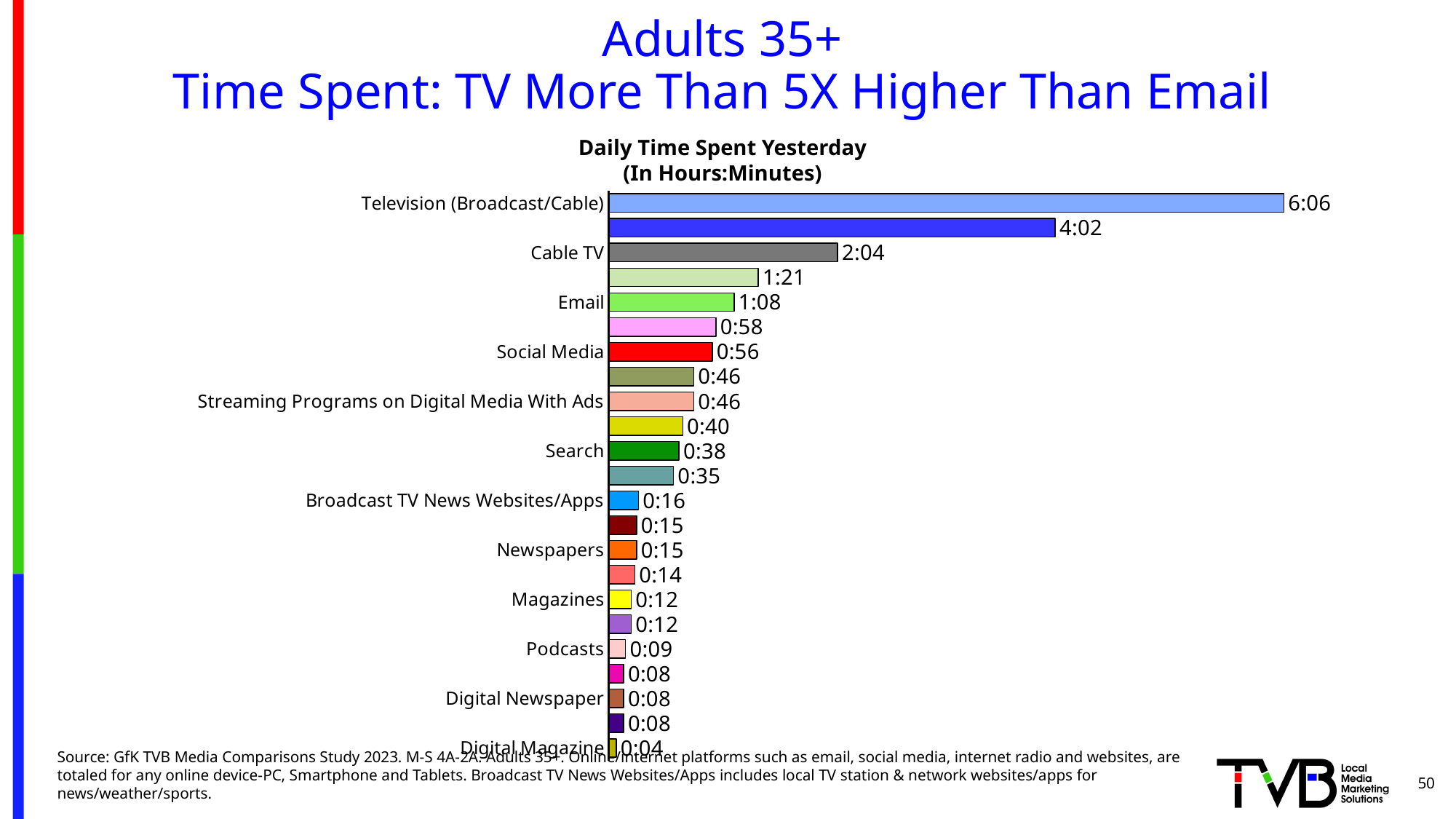
What is the difference in daily time spent between Cable TV and Email? 0:56 How much more daily time is spent on Television (Broadcast/Cable) than on Email? 4:58 Which category has the lowest daily time spent? Digital Magazine What is the daily time spent for Email? 1:08 What type of chart is shown on the slide? Bar chart How many bars are plotted in the chart? 23 What is the daily time spent for Television (Broadcast/Cable)? 6:06 What is the daily time spent for Search? 0:38 Which category has the highest daily time spent? Television (Broadcast/Cable) Which has a higher daily time spent, Newspapers or Magazines? Newspapers What is the daily time spent for Digital Magazine? 0:04 What is the daily time spent for Social Media? 0:56